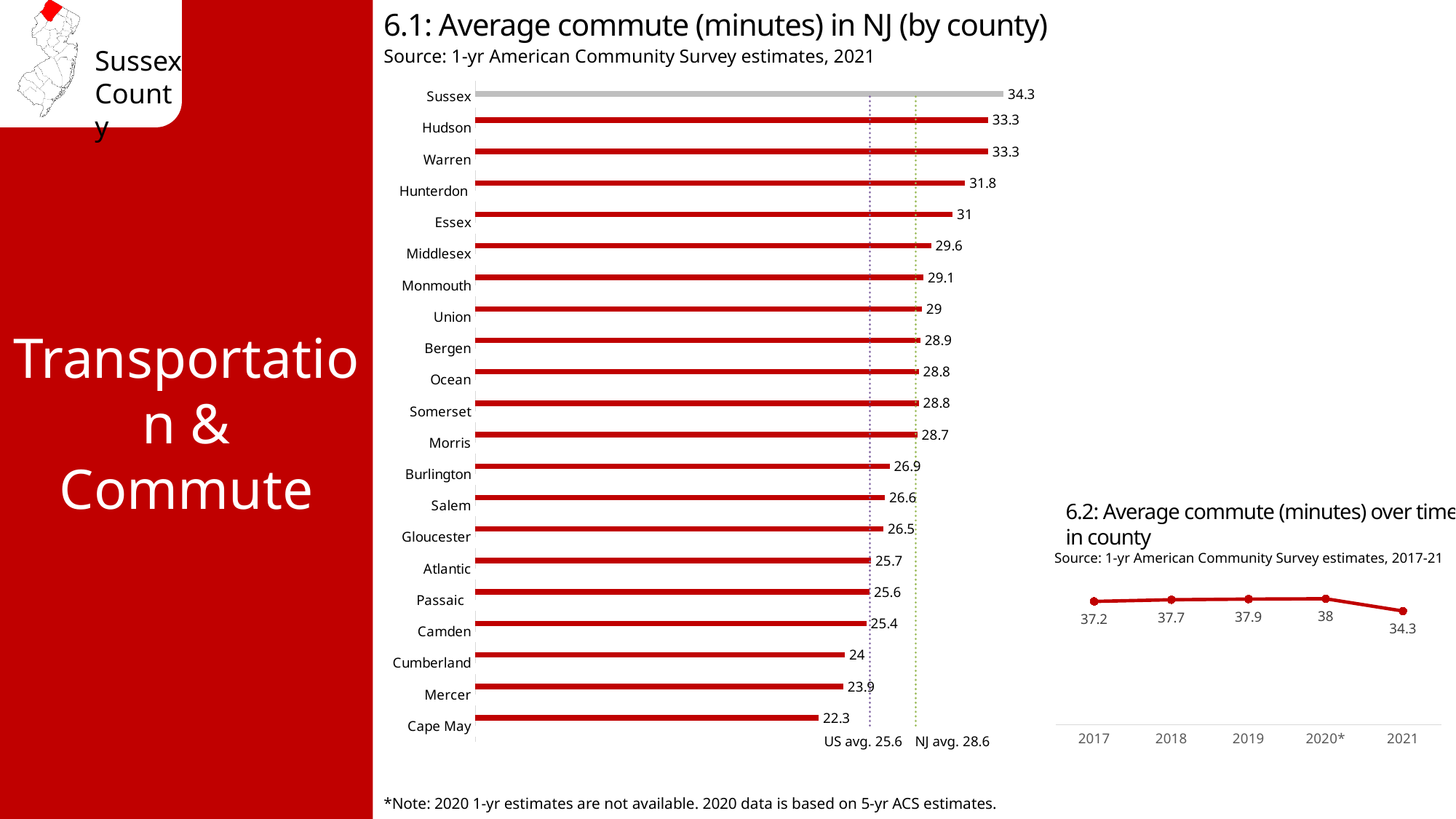
In chart 6.1, what is the NJ average commute shown by the dotted reference line? 28.6 What kind of chart is chart 6.1 (Average commute in NJ by county)? Bar chart In chart 6.1 (Average commute in NJ by county), which county has the highest average commute? Sussex In chart 6.1 (Average commute in NJ by county), what is the average commute for Sussex? 34.3 In chart 6.1 (Average commute in NJ by county), how many counties are shown? 21 In chart 6.2 (Average commute over time in county), what is the value for 2020*? 38 In chart 6.1 (Average commute in NJ by county), which has a longer average commute, Hunterdon or Essex? Hunterdon In chart 6.1 (Average commute in NJ by county), what is the average commute for Mercer? 23.9 In chart 6.1 (Average commute in NJ by county), what is the difference between Sussex and Cape May? 12 What kind of chart is chart 6.2 (Average commute over time in county)? Line chart In chart 6.2 (Average commute over time in county), what is the difference between 2020* and 2021? 3.7 In chart 6.1 (Average commute in NJ by county), which county has the lowest average commute? Cape May